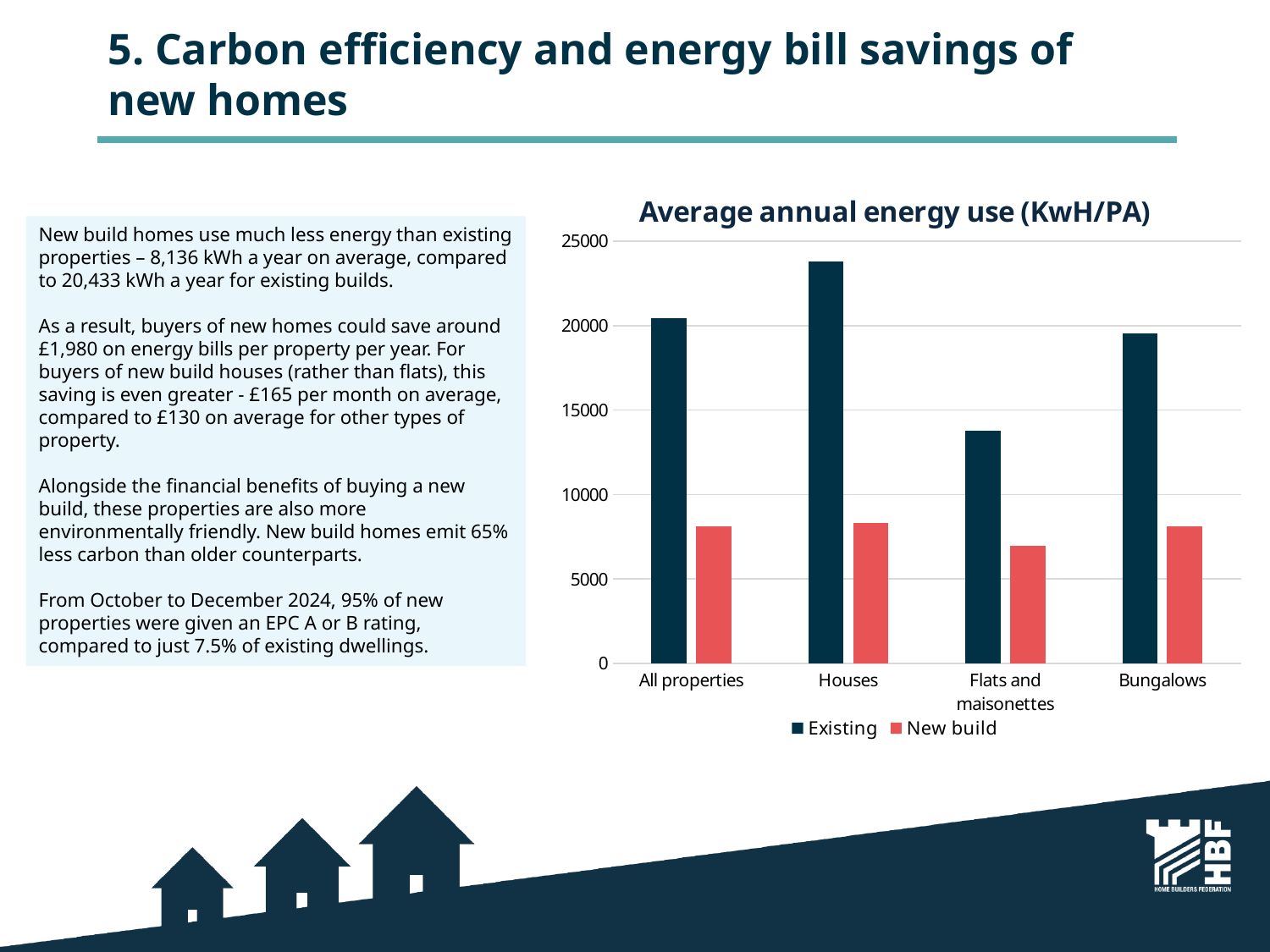
Is the Existing value for Houses greater or less than 20000? greater Is the Existing value for Flats and maisonettes greater or less than 15000? less How many property categories are shown on the x axis of the chart? 4 Is the New build value for Houses greater or less than 10000? less Which series is shown in red in the chart? New build Which category has the highest Existing value in the chart? Houses Which category has the lowest Existing value in the chart? Flats and maisonettes Which category has the lowest New build value in the chart? Flats and maisonettes What kind of chart is shown on the slide? bar chart How many series does the chart legend list? 2 Which is larger, the Existing value for Houses or the Existing value for Bungalows? Houses What is the title of the chart? Average annual energy use (KwH/PA)